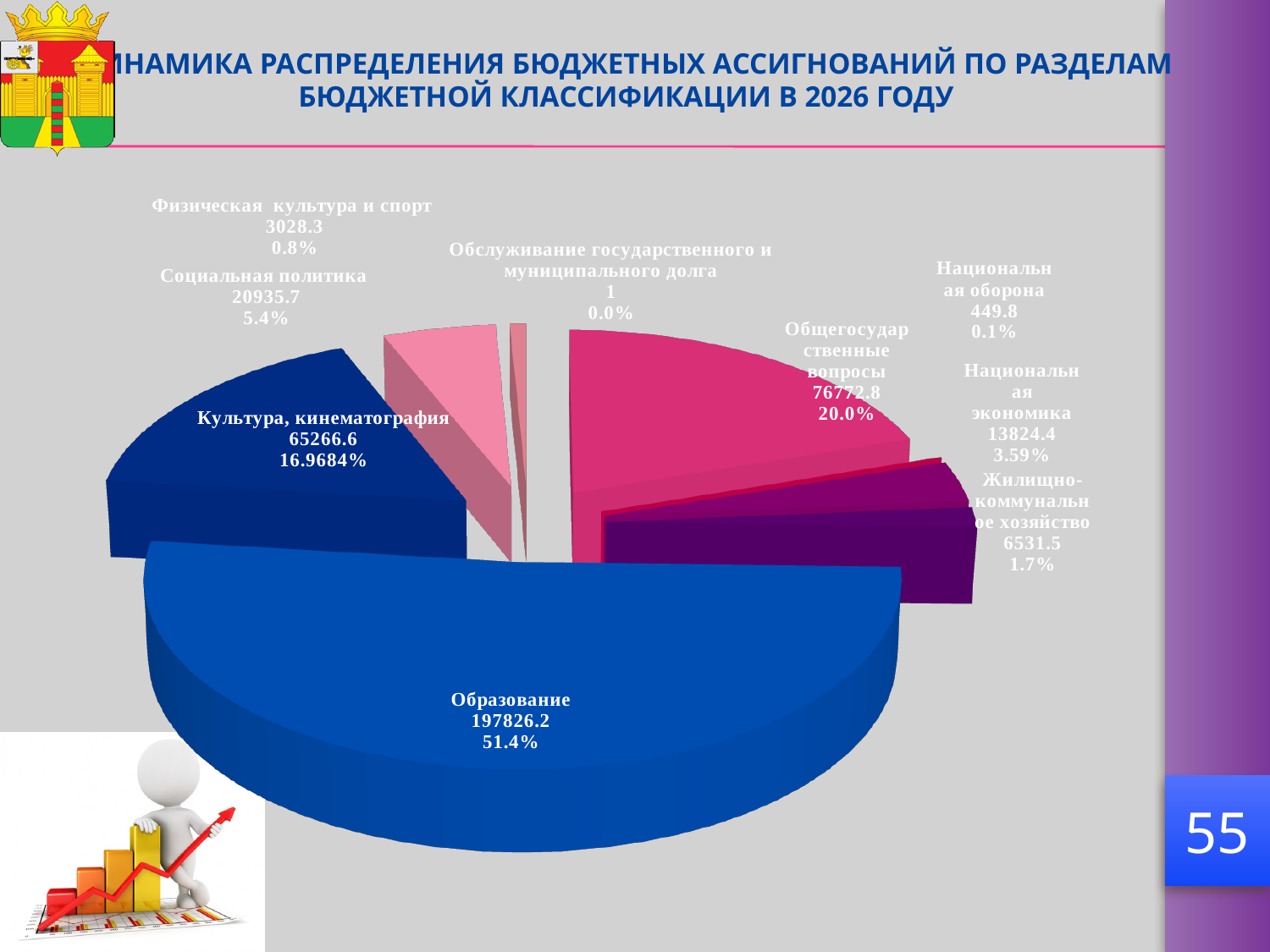
What is the value shown for Образование? 197826.2 Which is larger, the value for Национальная экономика or the value for Жилищно-коммунальное хозяйство? Национальная экономика What percentage is shown for Культура, кинематография? 16.9684% Which category has the largest slice of the pie? Образование How many categories are shown in the pie chart? 9 What percentage is shown for Национальная оборона? 0.1% Which category has the smallest value in the pie chart? Обслуживание государственного и муниципального долга What share of the pie does Образование represent? 51.4% What is the value shown for Социальная политика? 20935.7 What is the value shown for Общегосударственные вопросы? 76772.8 What kind of chart is shown on the slide? pie chart What is the difference between the values for Образование and Общегосударственные вопросы? 121053.4